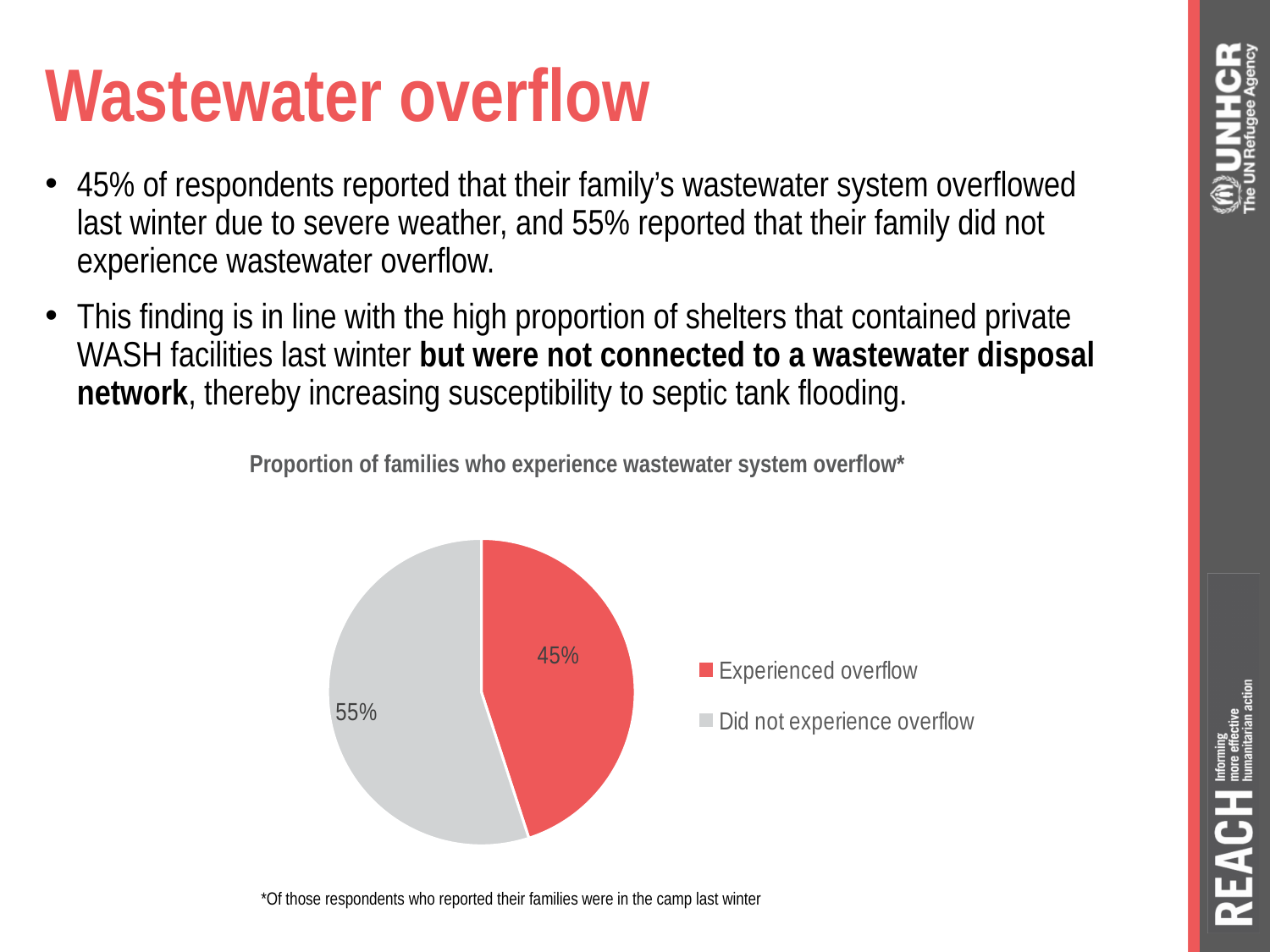
What is the difference in percentage points between the 'Did not experience overflow' and 'Experienced overflow' slices? 10 percentage points What is the title of the chart? Proportion of families who experience wastewater system overflow* What share of families did not experience wastewater system overflow? 55% How many slices does the pie chart have? 2 What share of families experienced wastewater system overflow? 45% Which category has the largest slice of the pie? Did not experience overflow What colour is the 'Experienced overflow' slice? Red Which category has the smallest slice of the pie? Experienced overflow Which is larger: the share that experienced overflow or the share that did not? Did not experience overflow What type of chart is shown on the slide? Pie chart How many entries does the legend list? 2